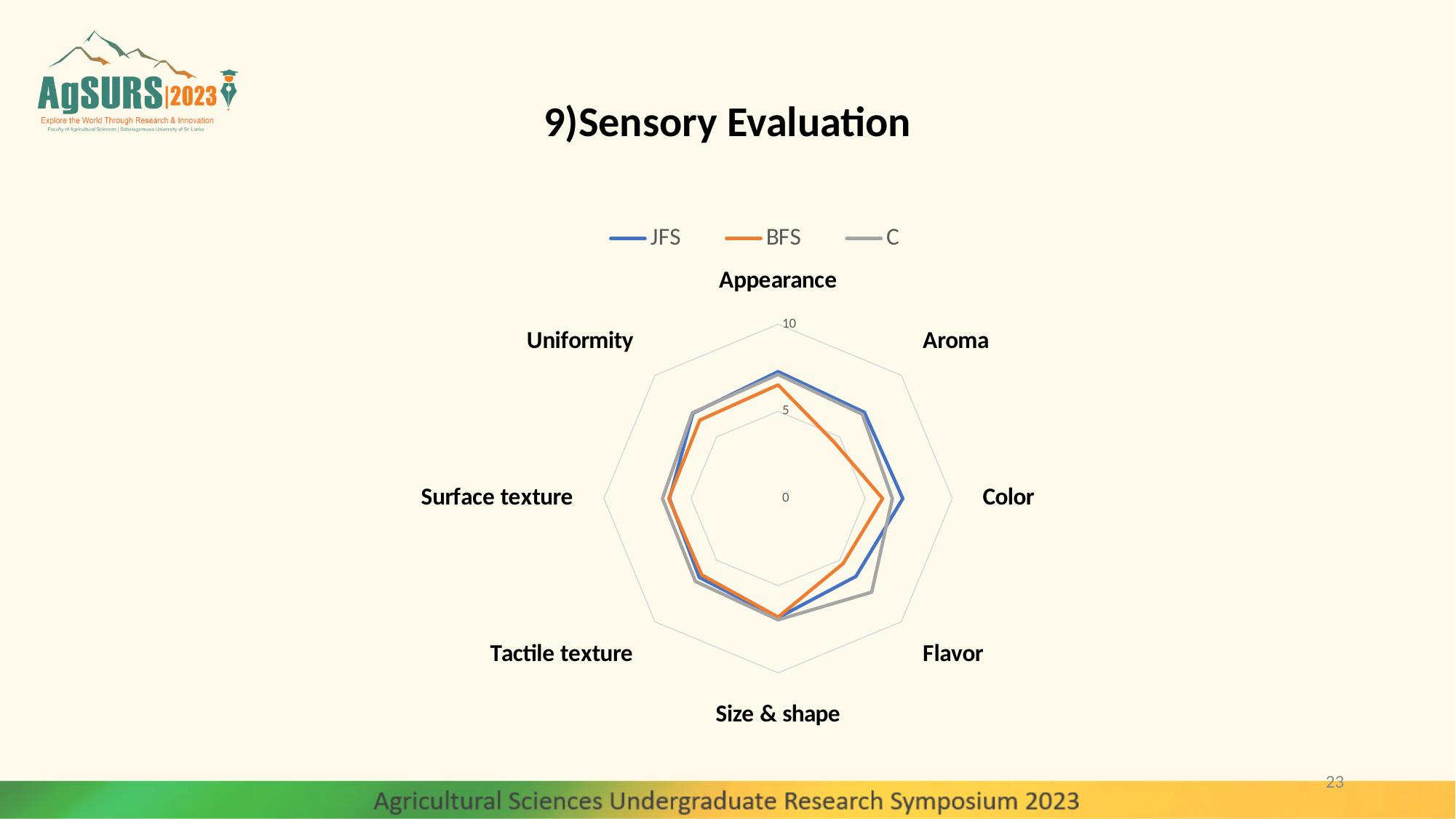
Is the value for C on Flavor greater or less than 5? greater Is the value for JFS on Color greater or less than 5? greater Is the value for BFS on Surface texture greater or less than 10? less For Color, which series has the larger value, JFS or BFS? JFS What is the title of the slide containing the chart? 9)Sensory Evaluation How many categories (axes) does the radar chart have? 8 For Aroma, which series has the larger value, JFS or BFS? JFS For Flavor, which series has the larger value, C or BFS? C How many series does the legend list? 3 What kind of chart is shown on the slide? Radar chart Which series is drawn in orange in the chart? BFS